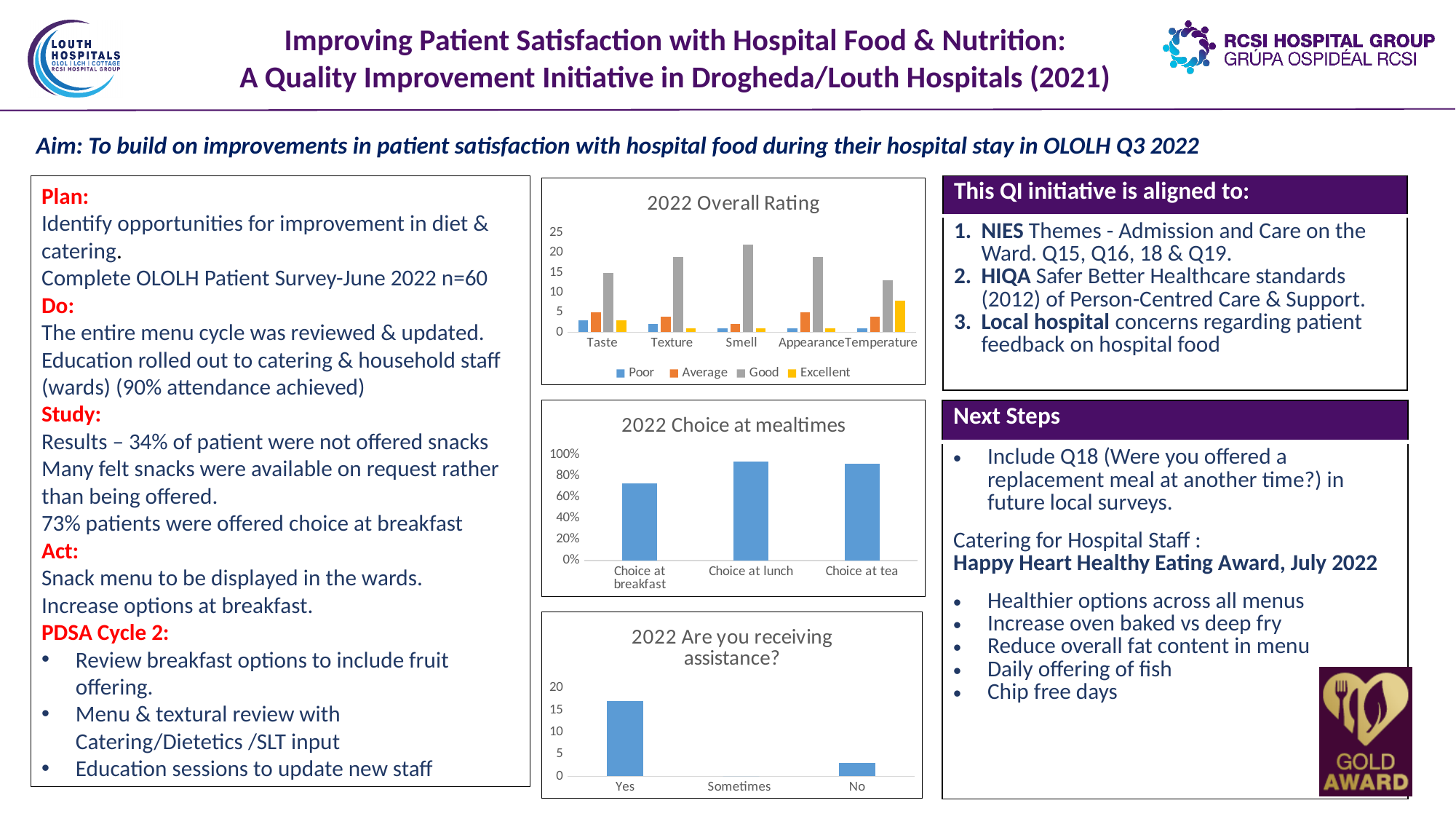
In the "2022 Are you receiving assistance?" chart, is the value for Yes greater or less than 15? greater In the "2022 Choice at mealtimes" chart, which is larger, Choice at lunch or Choice at breakfast? Choice at lunch In the "2022 Choice at mealtimes" chart, which category has the lowest value? Choice at breakfast What kind of chart is the "2022 Overall Rating" chart? bar chart In the "2022 Are you receiving assistance?" chart, which category has the highest value? Yes How many categories are shown on the x axis of the "2022 Overall Rating" chart? 5 How many series does the legend of the "2022 Overall Rating" chart list? 4 In the "2022 Overall Rating" chart, is the Excellent value for Temperature greater or less than 5? greater In the "2022 Overall Rating" chart, which series has the highest value for Smell? Good In the "2022 Overall Rating" chart, which category has the highest Good value? Smell In the "2022 Choice at mealtimes" chart, is the value for Choice at breakfast greater or less than 80%? less